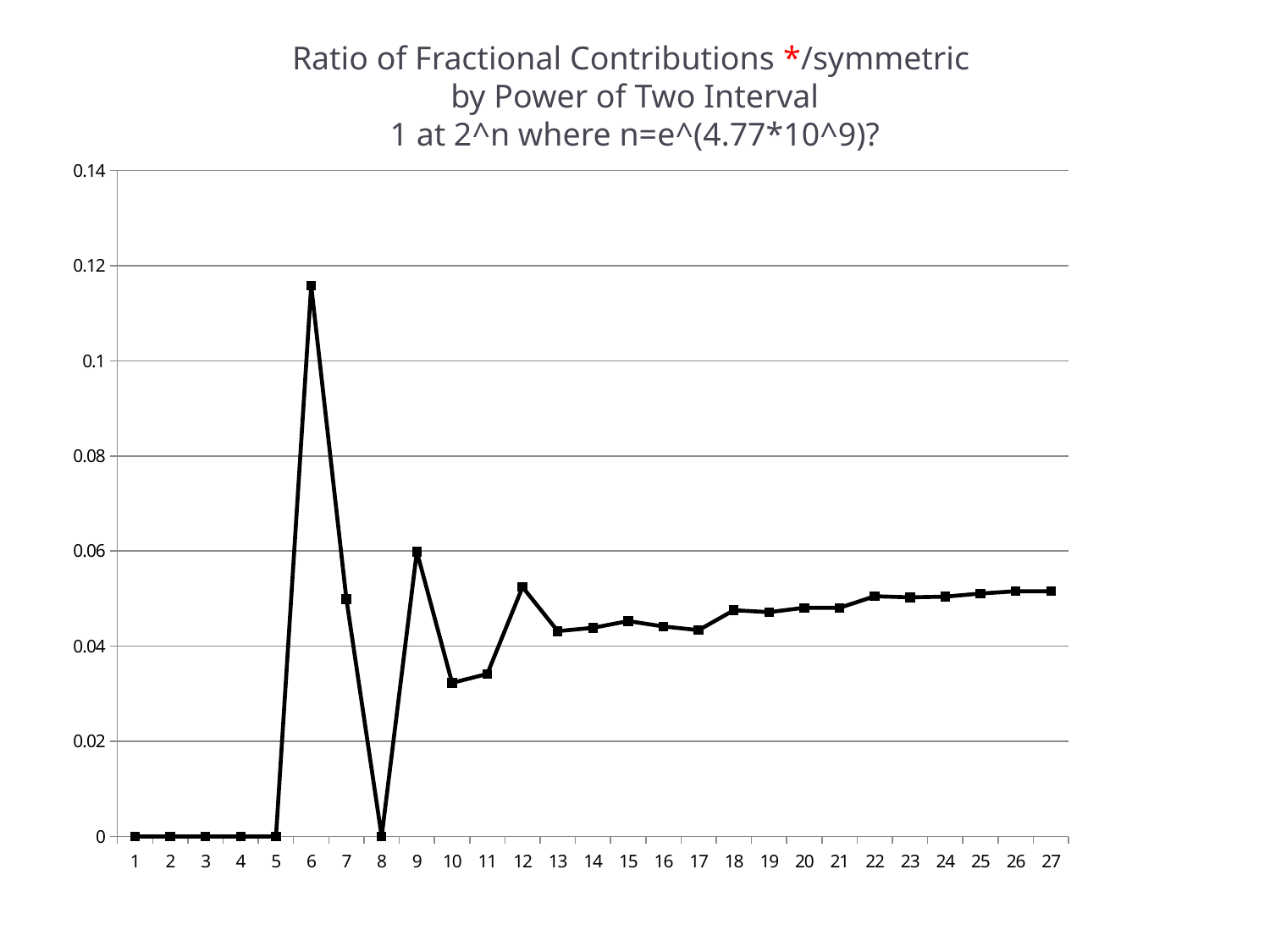
Do the values rise or fall from x = 18 to x = 27? rise Is the value at x = 6 greater or less than 0.1? greater Which x-axis category has the highest value? 6 Which has the larger value, x = 10 or x = 12? 12 What is the value at x = 8? 0 Is the value at x = 27 greater or less than 0.04? greater What kind of chart is shown on the slide? line chart What is the first line of the chart title? Ratio of Fractional Contributions */symmetric Is the value at x = 10 greater or less than 0.04? less How many points are plotted along the x axis? 27 Which has the larger value, x = 6 or x = 9? 6 What is the value at x = 3? 0